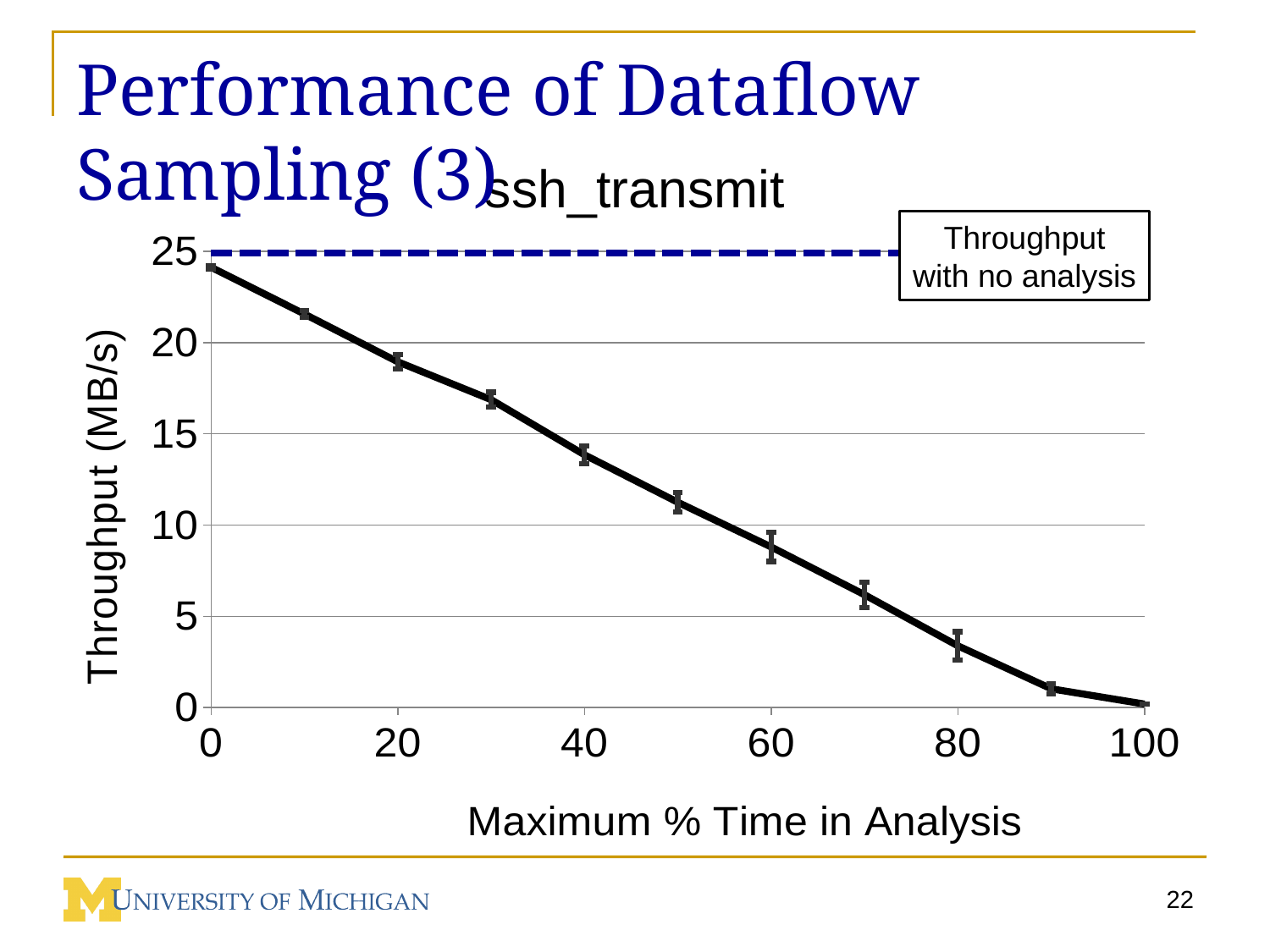
How many data points are plotted on the solid line? 11 Does throughput rise or fall as Maximum % Time in Analysis increases? fall At which Maximum % Time in Analysis value is throughput highest? 0 Which has higher throughput: 30% or 70% Maximum Time in Analysis? 30% Is the throughput at 0% Maximum Time in Analysis greater or less than 20 MB/s? greater Is the throughput at 20% Maximum Time in Analysis greater or less than 20 MB/s? less Is the throughput at 40% Maximum Time in Analysis greater or less than 15 MB/s? less What is the title of the chart? ssh_transmit What does the dashed horizontal line at the top of the chart represent? Throughput with no analysis What kind of chart is shown on the slide? line chart At which Maximum % Time in Analysis value is throughput lowest? 100